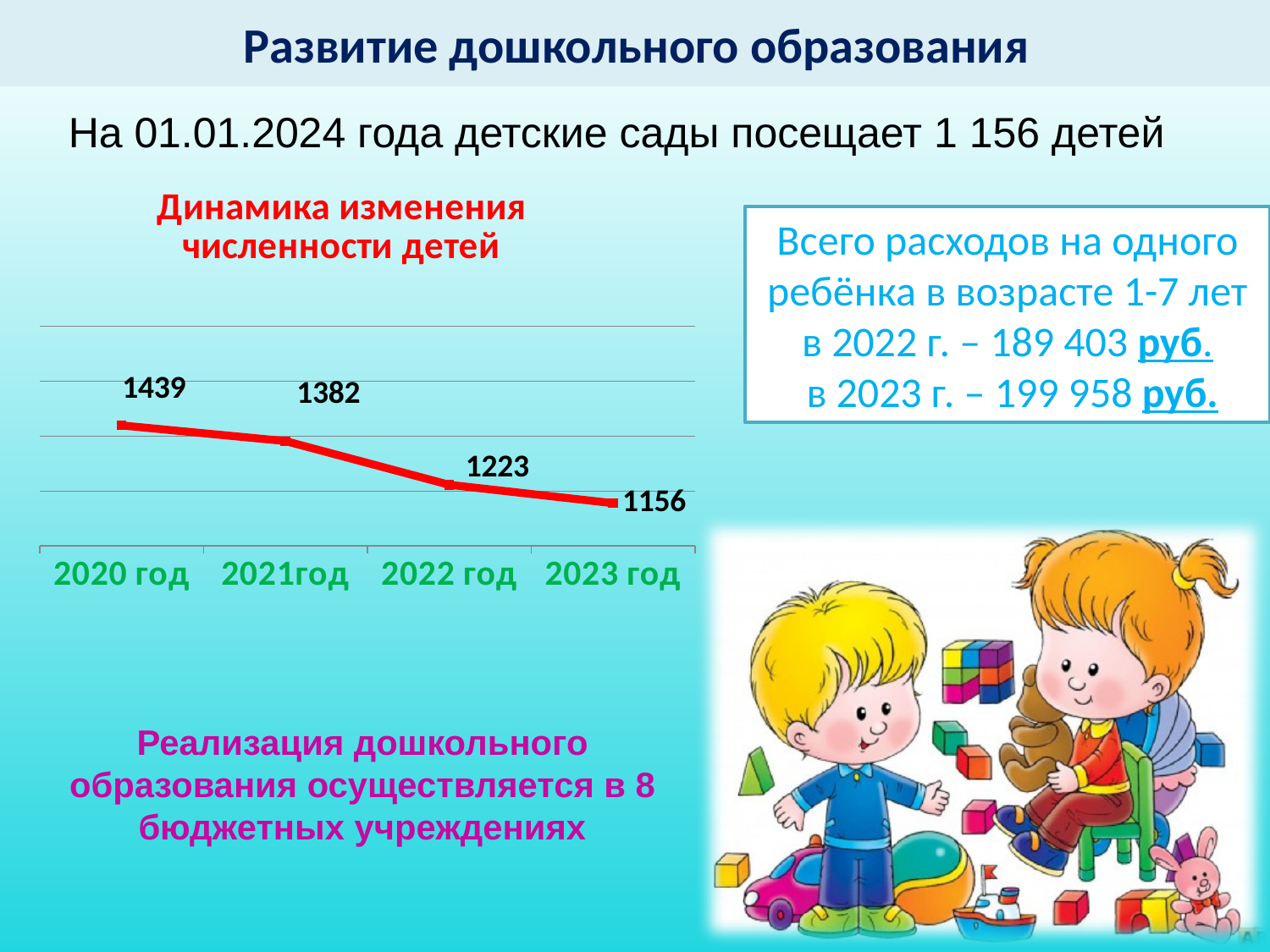
Do the values rise or fall from 2020 год to 2023 год? fall What is the value for 2023 год in the chart? 1156 How many years are plotted in the chart? 4 What kind of chart is shown on the slide? line chart Which year has the lowest value in the chart? 2023 год What is the value for 2022 год in the chart? 1223 What is the difference between the values for 2020 год and 2023 год? 283 What is the value for 2020 год in the chart 'Динамика изменения численности детей'? 1439 Which year has the highest value in the chart? 2020 год What is the value for 2021год in the chart? 1382 What is the difference between the values for 2021год and 2022 год? 159 Which is larger, the value for 2021год or the value for 2022 год? 2021год